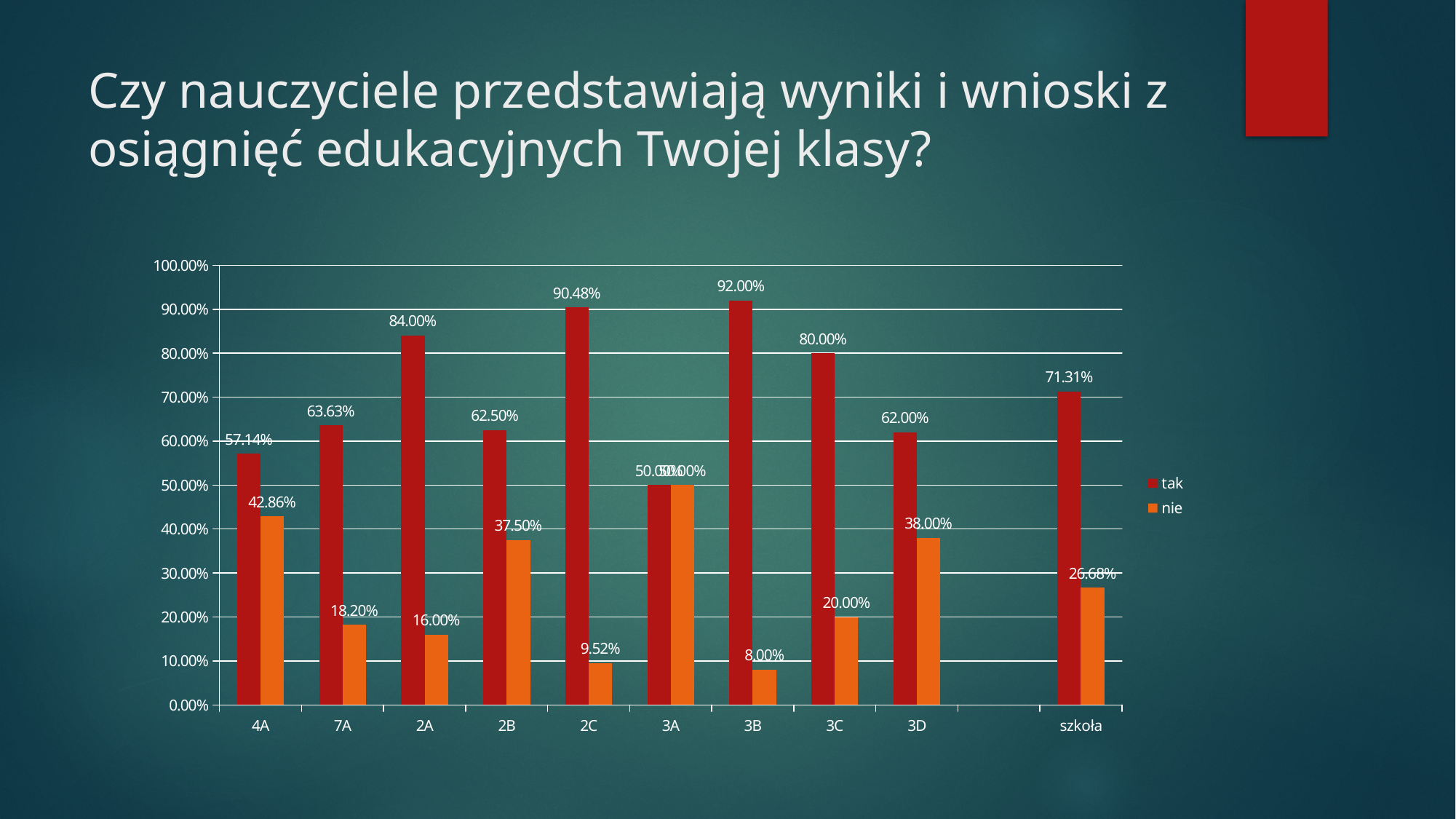
What is the value of "tak" for szkoła? 71.31% What is the difference between the "tak" and "nie" values for class 2A? 68.00% How many categories are shown on the x axis? 10 What kind of chart is shown on the slide? bar chart Which is larger: the "tak" value for 2C or the "tak" value for 3C? 2C How many series does the legend list? 2 What is the value of "tak" for class 3B? 92.00% What is the value of "nie" for class 2C? 9.52% Is the "nie" value for class 3D greater or less than 30.00%? greater Which category has the highest "tak" value? 3B What is the value of "nie" for class 4A? 42.86% Which category has the lowest "nie" value? 3B